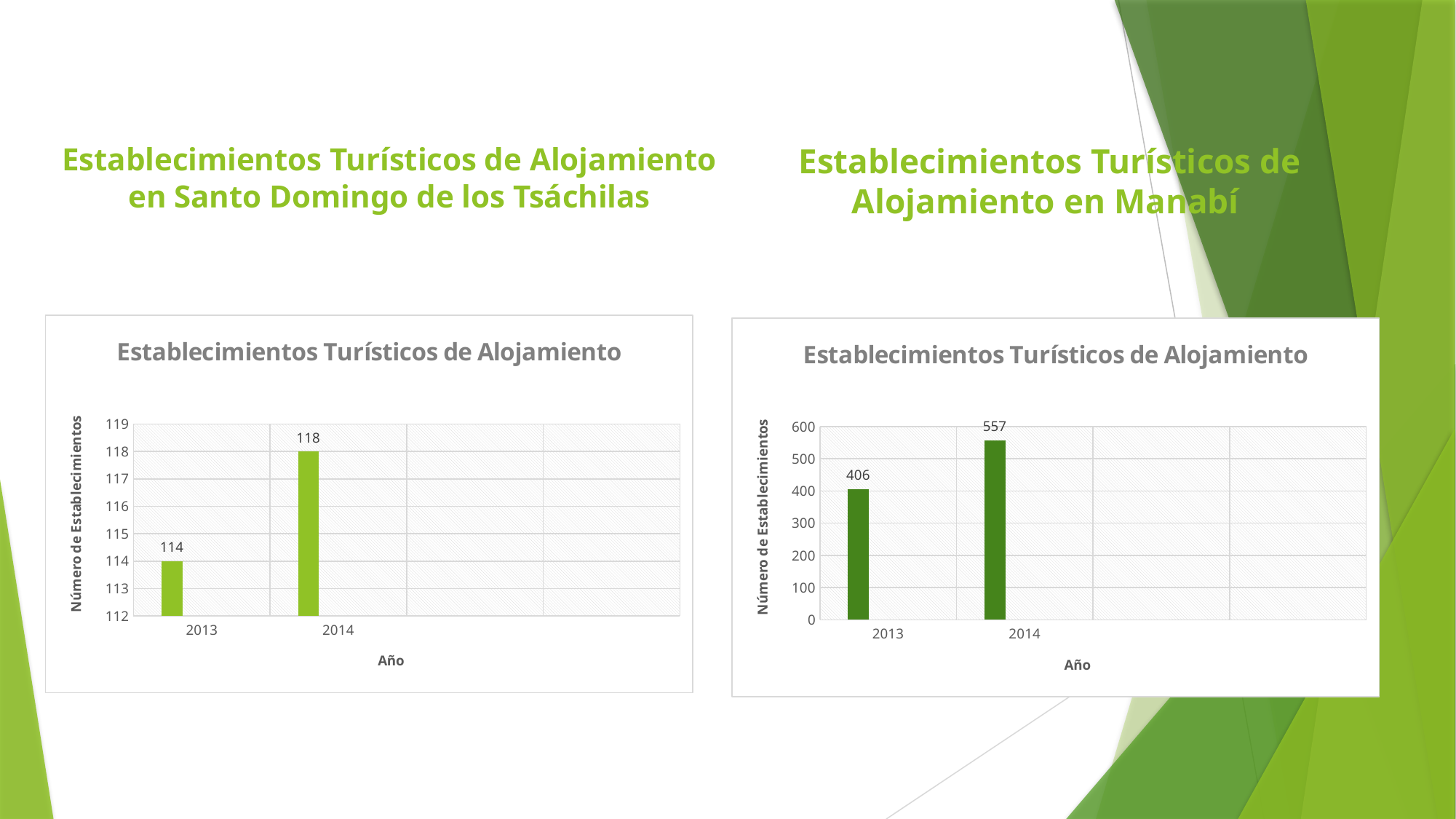
In the left chart (Santo Domingo de los Tsáchilas), what is the value for 2013? 114 In the left chart (Santo Domingo de los Tsáchilas), what is the value for 2014? 118 What kind of chart is the right chart (Manabí)? bar chart In the right chart (Manabí), is the value for 2013 greater or less than 500? less In the right chart (Manabí), what is the value for 2014? 557 In the right chart (Manabí), what is the difference between the 2014 and 2013 values? 151 In the right chart (Manabí), what is the value for 2013? 406 In the right chart (Manabí), do the values rise or fall from 2013 to 2014? rise In the right chart (Manabí), which year has the highest value? 2014 In the left chart (Santo Domingo de los Tsáchilas), what is the difference between the 2014 and 2013 values? 4 How many years are shown on the x axis of the left chart (Santo Domingo de los Tsáchilas)? 2 In the left chart (Santo Domingo de los Tsáchilas), which year has the lowest value? 2013